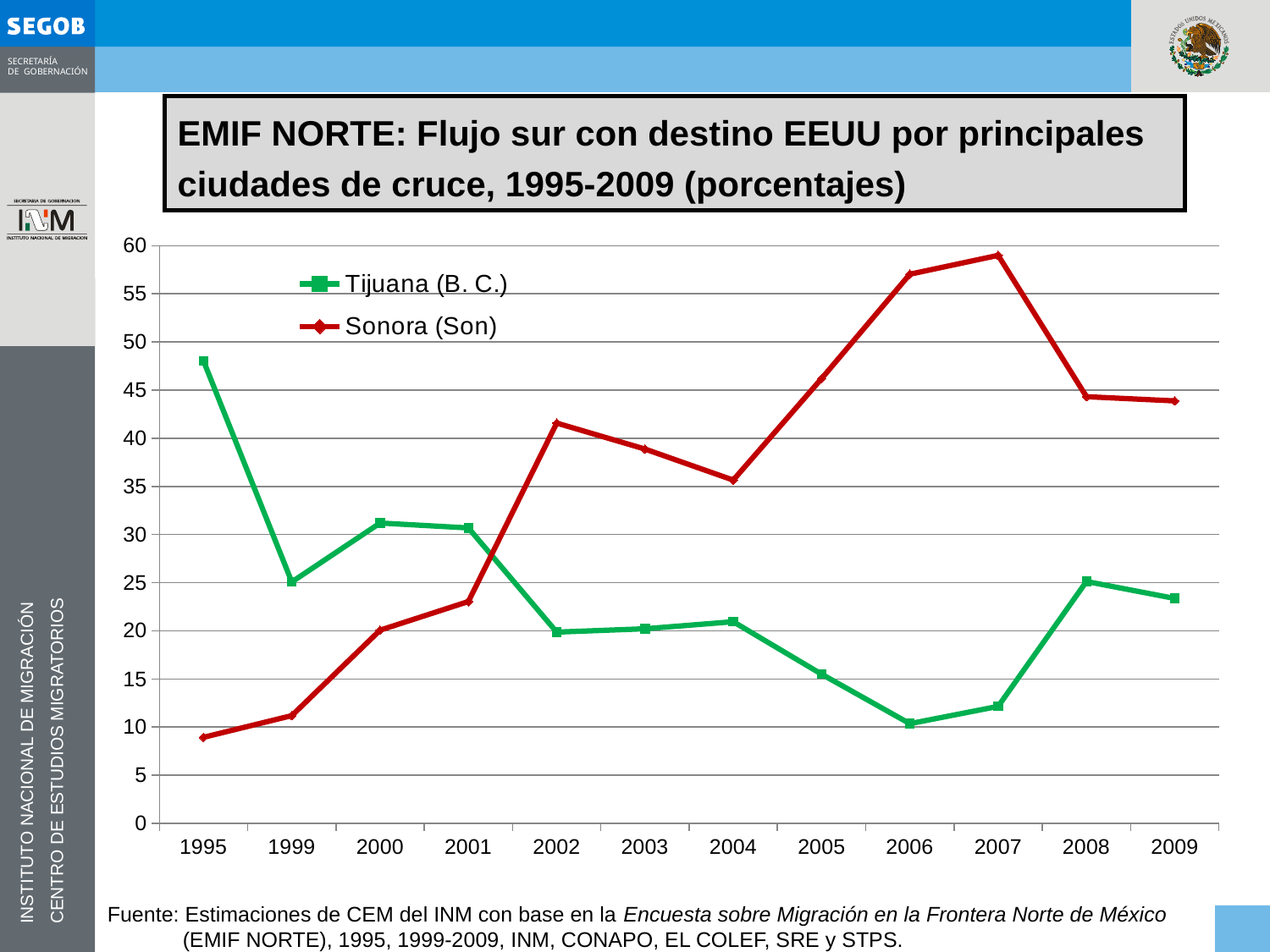
Does the Sonora (Son) series generally rise or fall between 1995 and 2007? Rise Is the value for Tijuana (B. C.) in 2006 greater or less than 15? less How many years are plotted along the x axis? 12 Is the value for Sonora (Son) in 2006 greater or less than 55? greater In 2007, which series has the higher value, Tijuana (B. C.) or Sonora (Son)? Sonora (Son) What kind of chart is shown on the slide? Line chart How many series does the legend list? 2 In which year does the Sonora (Son) series have its lowest value? 1995 In which year does the Tijuana (B. C.) series reach its highest value? 1995 In which year does the Sonora (Son) series reach its highest value? 2007 In which year does the Tijuana (B. C.) series have its lowest value? 2006 Is the value for Tijuana (B. C.) in 1995 greater or less than 45? greater